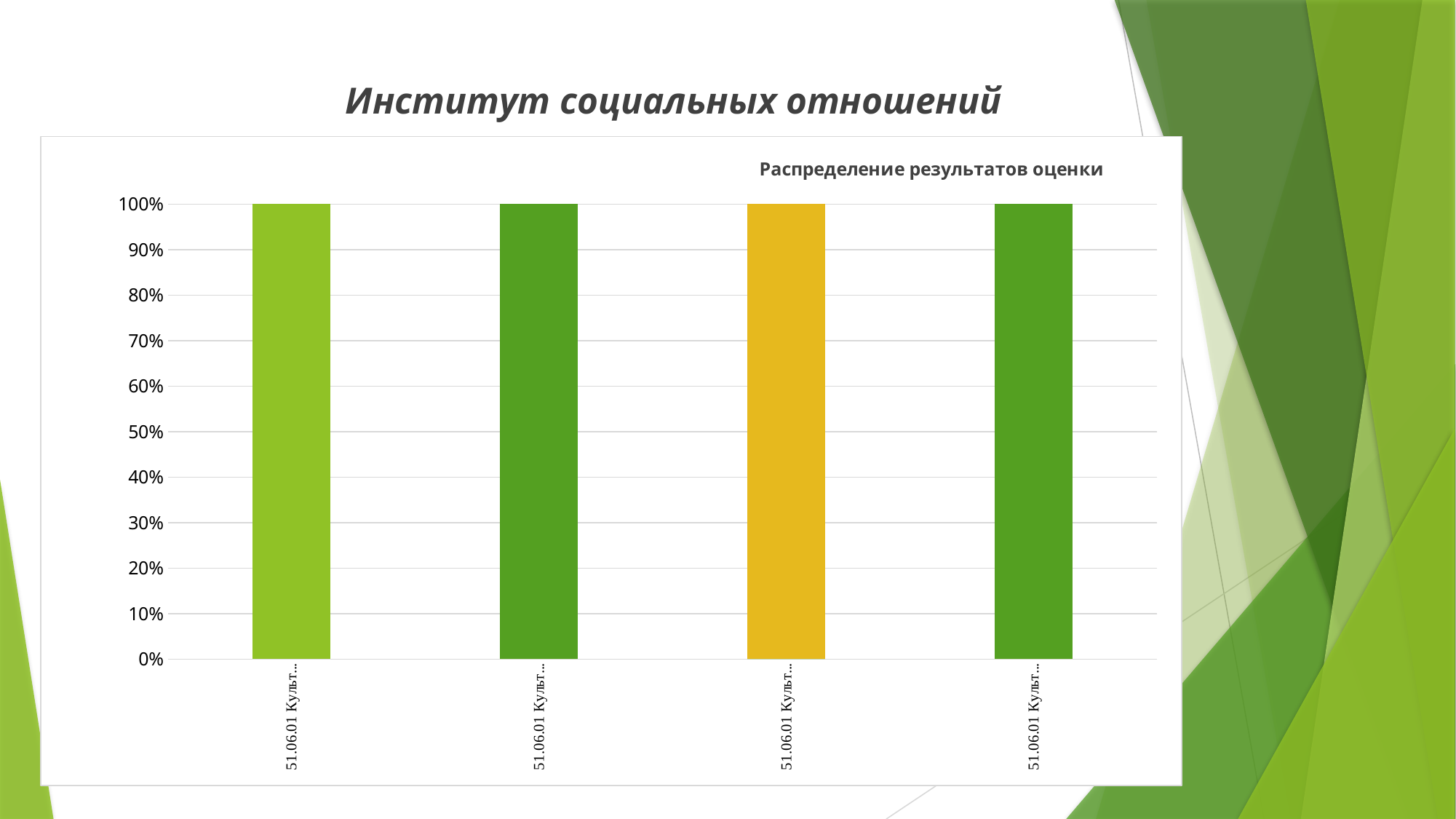
Is the value of the fourth bar greater or less than 90%? greater What kind of chart is shown on the slide? bar chart Is the value of the second bar greater or less than 50%? greater What value does the third bar (the yellow one) reach? 100% What value does the fourth (rightmost) bar reach? 100% What is the title of the chart? Распределение результатов оценки What value does the first (leftmost) bar reach? 100% How many bars are plotted in the chart? 4 What is the highest value shown on the vertical axis? 100% Do the bar values rise, fall, or stay the same from left to right? stay the same What is the difference between the value of the first bar and the value of the third bar? 0%